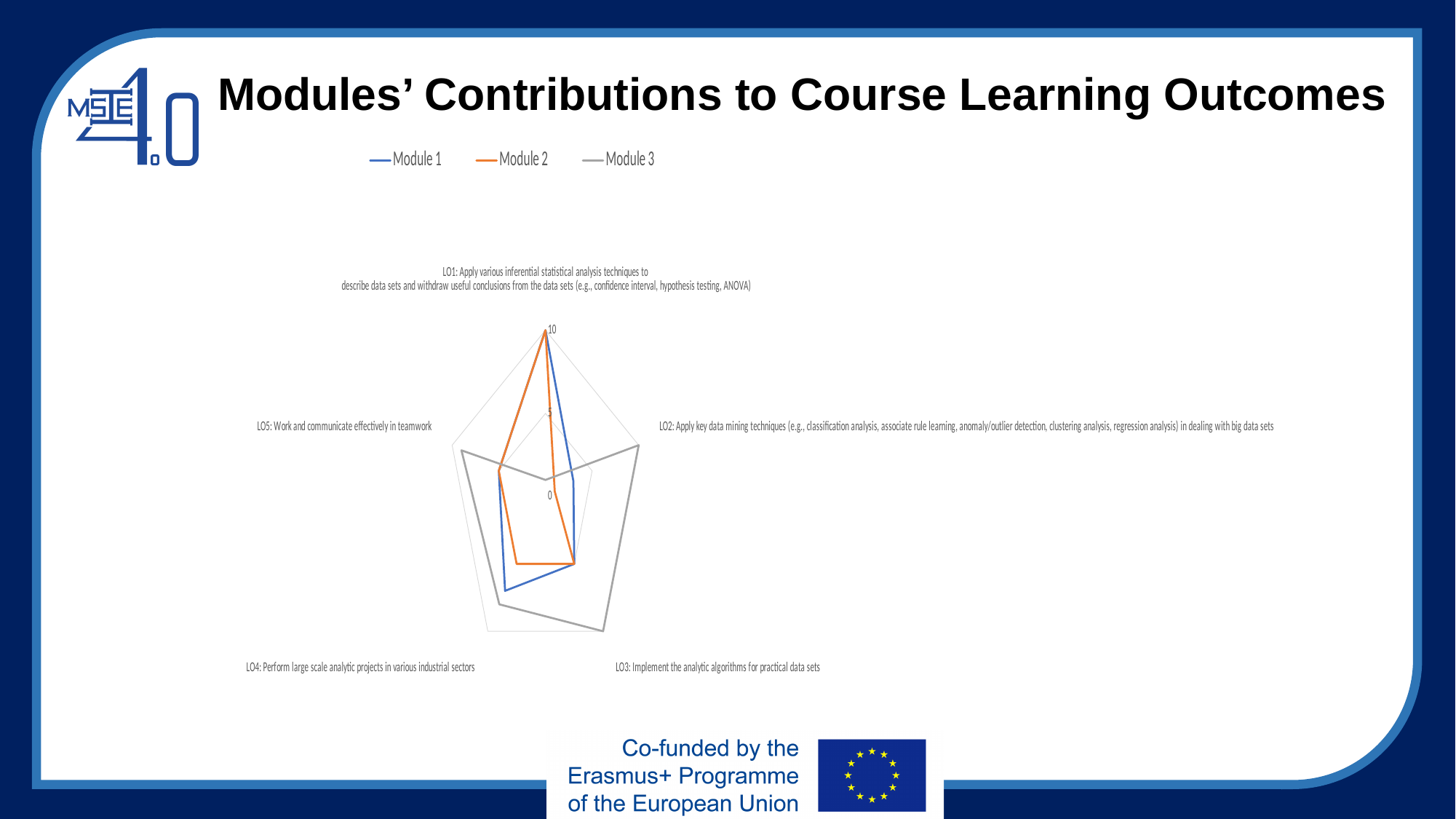
How many series does the legend list? 3 What is the value for Module 3 on LO2? 10 Which module has the highest value on LO3? Module 3 On LO4, which is larger: the value for Module 1 or Module 2? Module 1 Is the value for Module 1 on LO4 greater or less than 5? greater What colour is the line for Module 2 in the legend? Orange Is the value for Module 1 on LO2 greater or less than 5? less How many learning outcome axes does the radar chart have? 5 What kind of chart is shown on the slide? Radar chart What is the value for Module 1 on LO1? 10 On which learning outcome does Module 3 have its lowest value? LO1